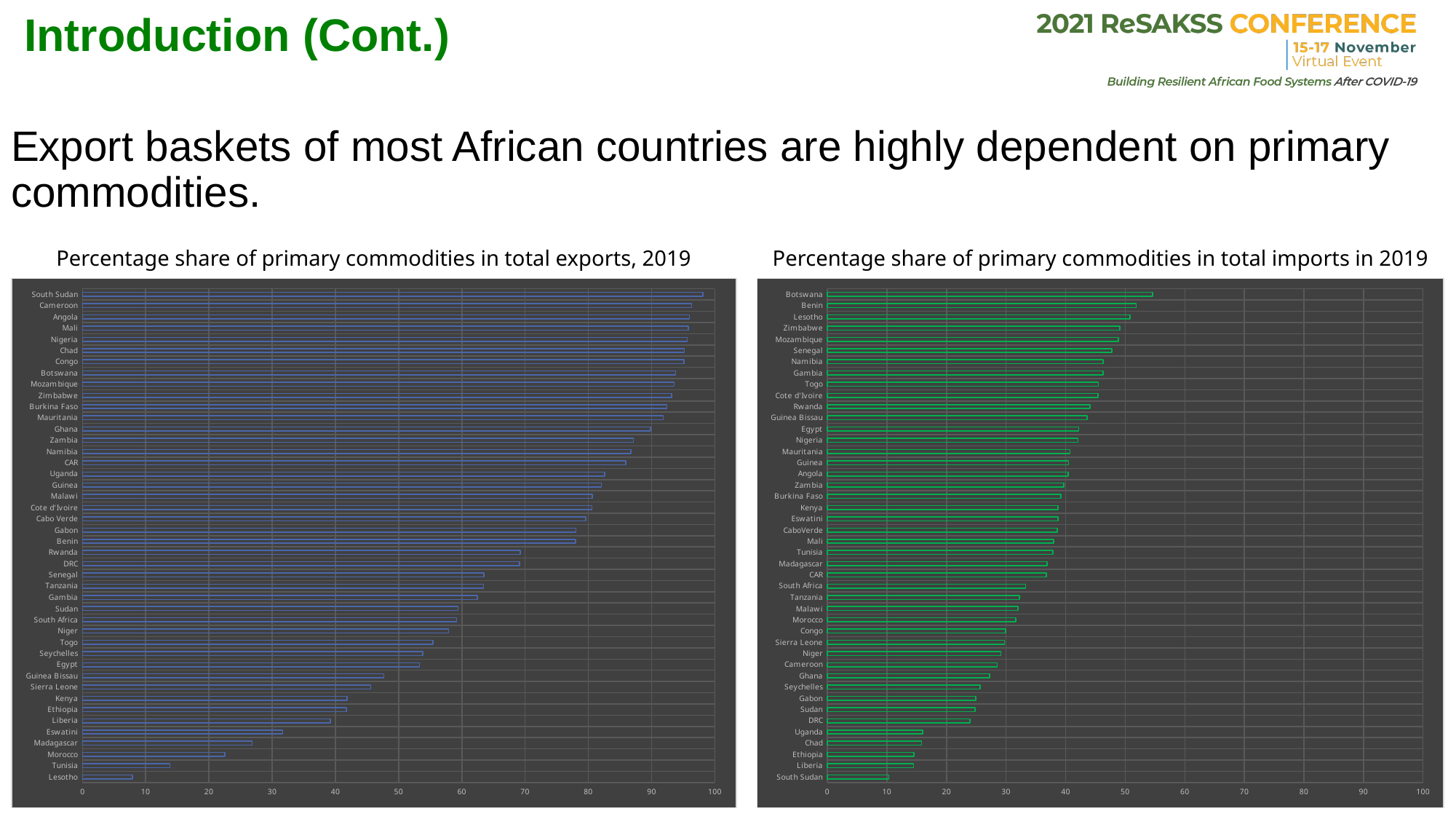
In the 'Percentage share of primary commodities in total exports, 2019' chart, which country has the highest value? South Sudan In the 'Percentage share of primary commodities in total imports in 2019' chart, which has the larger value, Egypt or Ghana? Egypt In the 'Percentage share of primary commodities in total exports, 2019' chart, which has the larger value, Ghana or Senegal? Ghana In the 'Percentage share of primary commodities in total exports, 2019' chart, which country has the lowest value? Lesotho In the 'Percentage share of primary commodities in total imports in 2019' chart, which country has the lowest value? South Sudan How many countries are shown in the 'Percentage share of primary commodities in total imports in 2019' chart? 44 In the 'Percentage share of primary commodities in total exports, 2019' chart, is the value for Morocco greater or less than 30? less In the 'Percentage share of primary commodities in total imports in 2019' chart, which country has the highest value? Botswana In the 'Percentage share of primary commodities in total imports in 2019' chart, is the value for Botswana greater or less than 50? greater What kind of chart is the 'Percentage share of primary commodities in total exports, 2019' chart? bar chart In the 'Percentage share of primary commodities in total exports, 2019' chart, is the value for Egypt greater or less than 50? greater